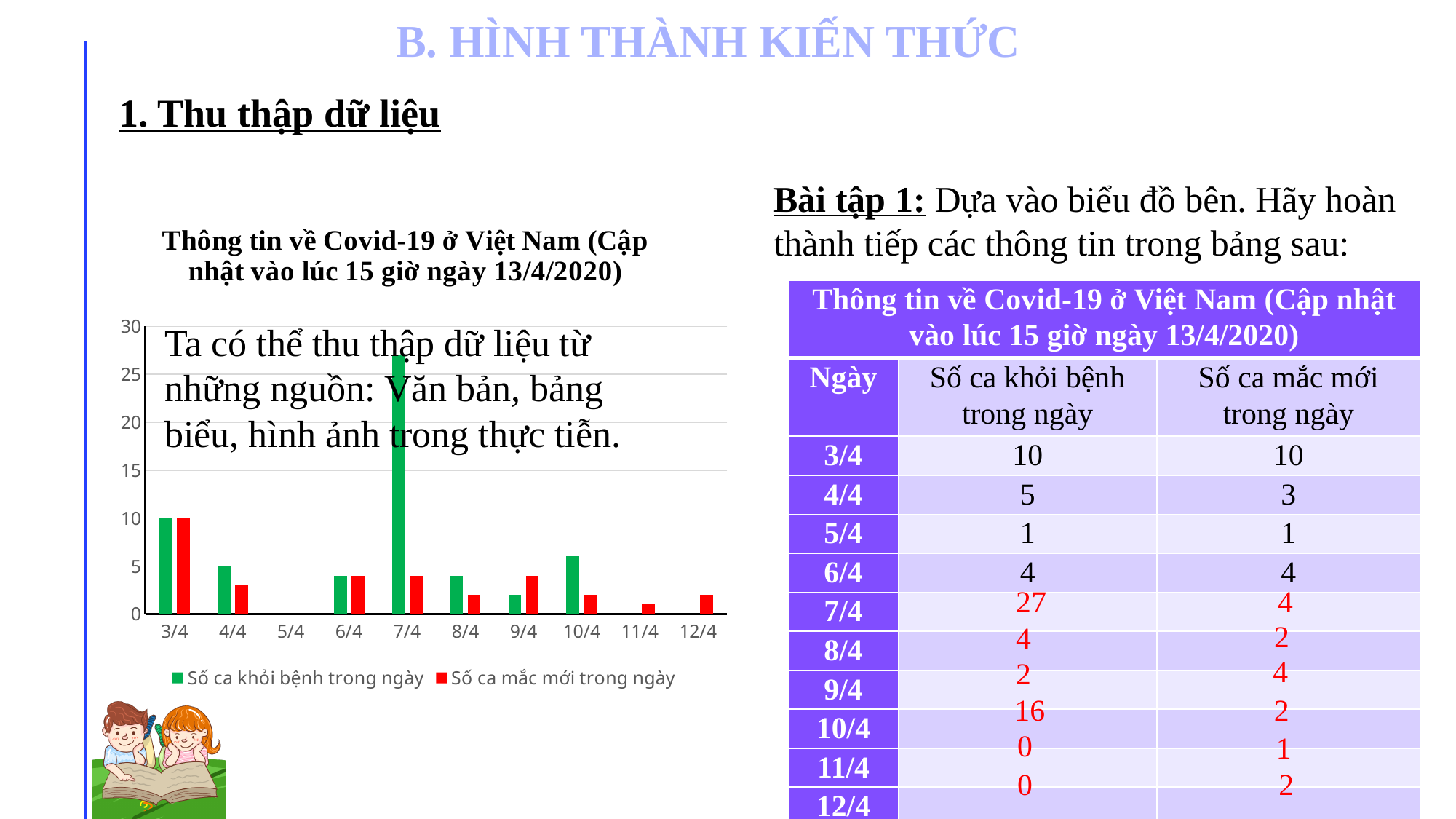
Is the value for 'Số ca khỏi bệnh trong ngày' on 7/4 greater or less than 25? greater What kind of chart is shown on the slide? bar chart On 4/4, which series has the larger value: 'Số ca khỏi bệnh trong ngày' or 'Số ca mắc mới trong ngày'? Số ca khỏi bệnh trong ngày How many series does the chart's legend list? 2 What is the value of 'Số ca khỏi bệnh trong ngày' on 3/4? 10 What is the value of 'Số ca khỏi bệnh trong ngày' on 4/4? 5 How many dates are shown along the x axis of the chart? 10 Is the value for 'Số ca mắc mới trong ngày' on 8/4 greater or less than 5? less Is the value for 'Số ca khỏi bệnh trong ngày' on 10/4 greater or less than 5? greater Which colour represents 'Số ca mắc mới trong ngày' in the chart? red On which date is 'Số ca khỏi bệnh trong ngày' highest? 7/4 What is the value of 'Số ca mắc mới trong ngày' on 3/4? 10